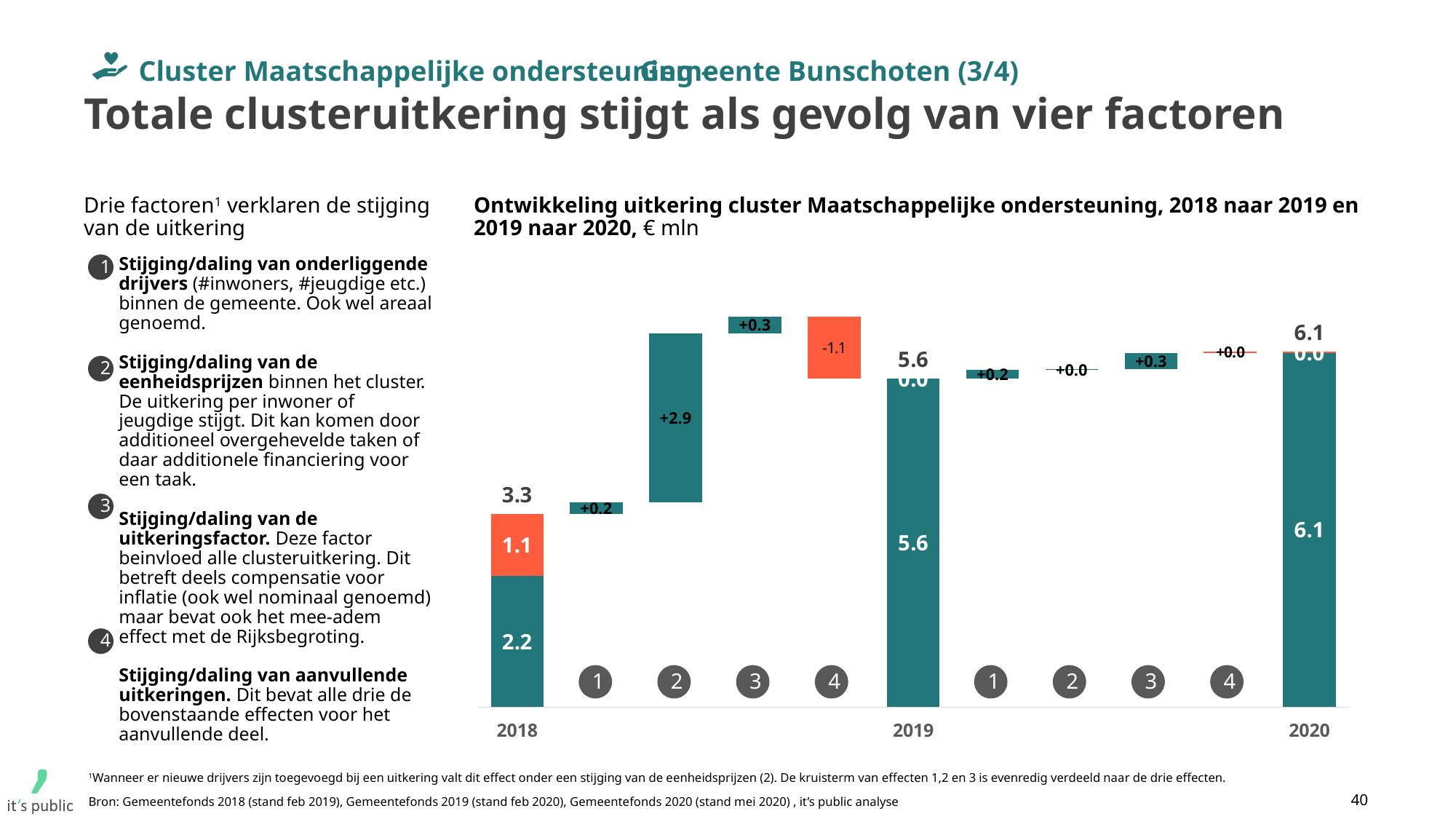
What is the value of factor 2 (eenheidsprijzen) between 2018 and 2019? +2.9 What is the total uitkering shown for 2019? 5.6 Do the yearly totals rise or fall from 2018 to 2020? Rise What is the total uitkering shown for 2020? 6.1 Which year has the higher total uitkering, 2018 or 2019? 2019 What are the two components that make up the 2018 bar? 2.2 and 1.1 What is the value of factor 3 (uitkeringsfactor) between 2019 and 2020? +0.3 What is the value of factor 4 (aanvullende uitkeringen) between 2018 and 2019? -1.1 What unit is the chart expressed in, according to its title? € mln Which of the four factors between 2018 and 2019 has the largest positive effect? Factor 2 (+2.9) What is the difference between the 2020 total and the 2018 total? 2.8 What is the total uitkering shown for 2018? 3.3